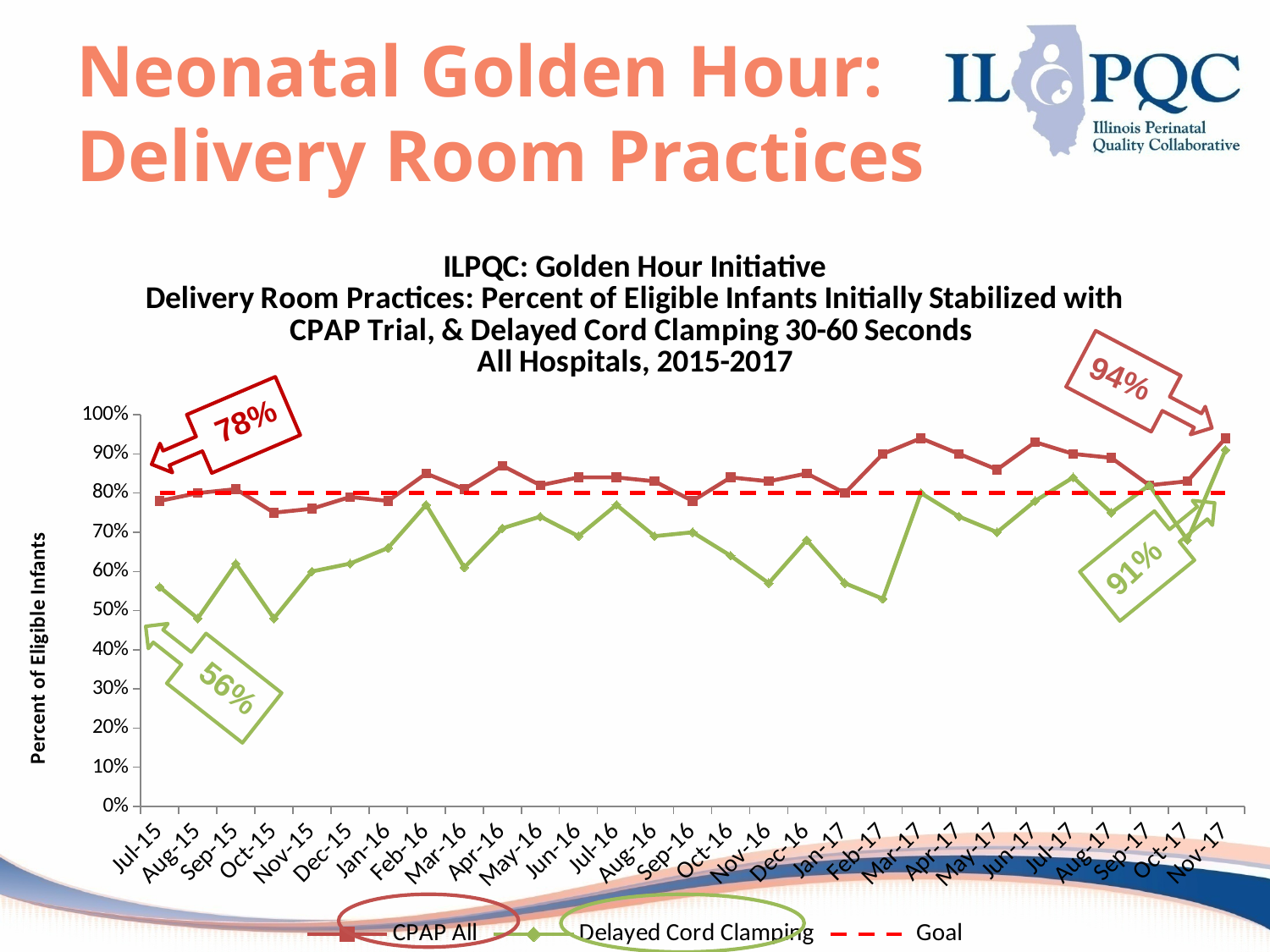
What is the Delayed Cord Clamping value for Jul-15? 56% By how many percentage points did CPAP All increase from Jul-15 to Nov-17? 16 percentage points Overall, does the Delayed Cord Clamping line rise or fall from Jul-15 to Nov-17? rise In Jul-15, which series had the higher value, CPAP All or Delayed Cord Clamping? CPAP All What is the CPAP All value for Nov-17? 94% What kind of chart is shown on the slide? line chart What is the CPAP All value for Jul-15? 78% Is the Delayed Cord Clamping value for Feb-17 greater or less than 60%? less How many entries does the legend list? 3 How many months are shown on the x axis? 29 By how many percentage points did Delayed Cord Clamping increase from Jul-15 to Nov-17? 35 percentage points What is the Delayed Cord Clamping value for Nov-17? 91%